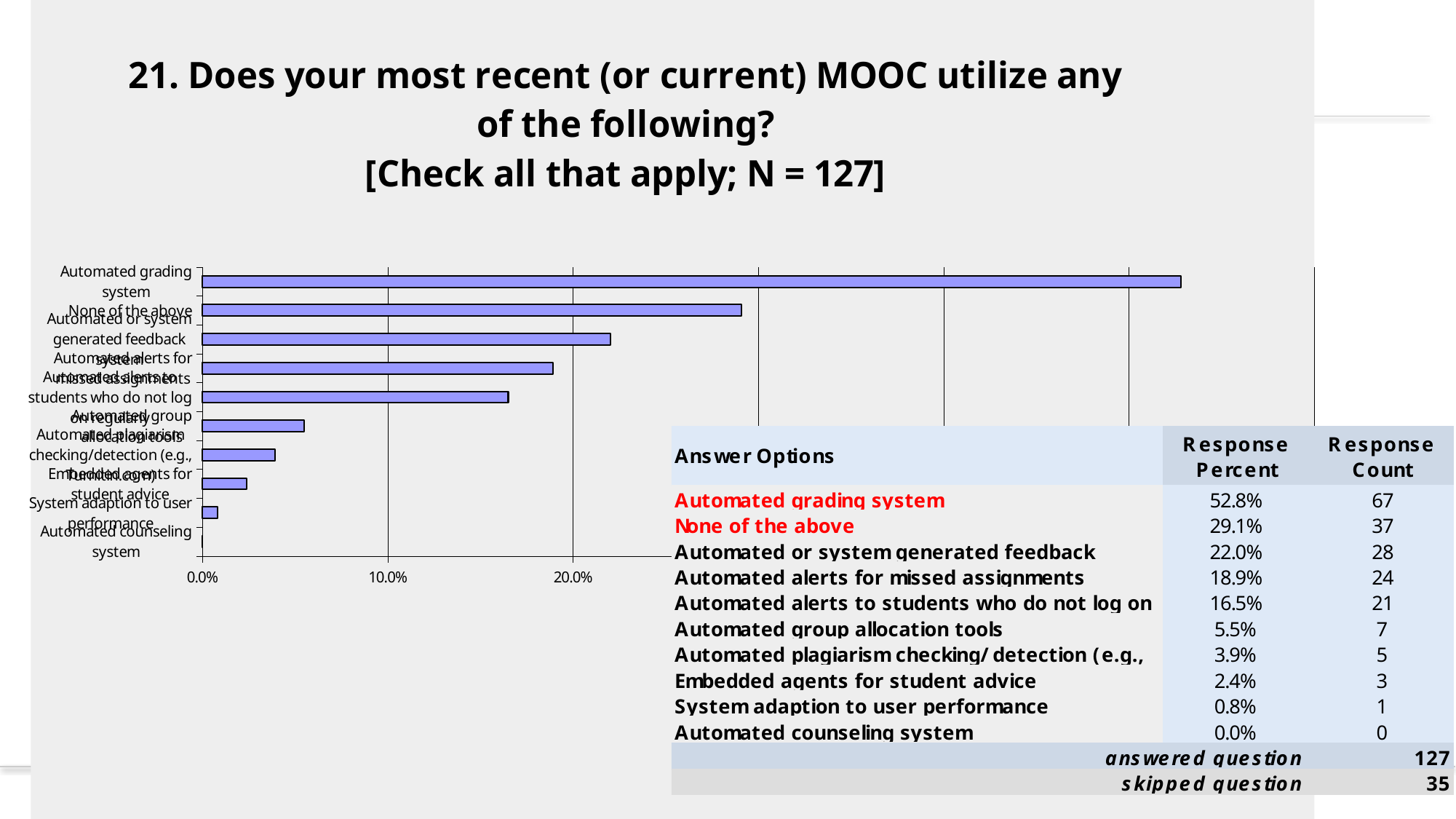
What is the difference in response percent between Automated grading system and None of the above? 23.7% How many answer options are plotted in the chart? 10 What kind of chart is shown on the slide? bar chart Which answer option has the lowest response percent? Automated counseling system What is the response percent for Automated grading system? 52.8% What is the response count for None of the above? 37 How many respondents answered the question? 127 What is the response count for Automated alerts to students who do not log on? 21 Which answer option has the highest response percent? Automated grading system Which has a larger response count, Automated group allocation tools or Embedded agents for student advice? Automated group allocation tools Is the value for Automated or system generated feedback greater or less than 20.0%? greater What is the response percent for Automated alerts for missed assignments? 18.9%